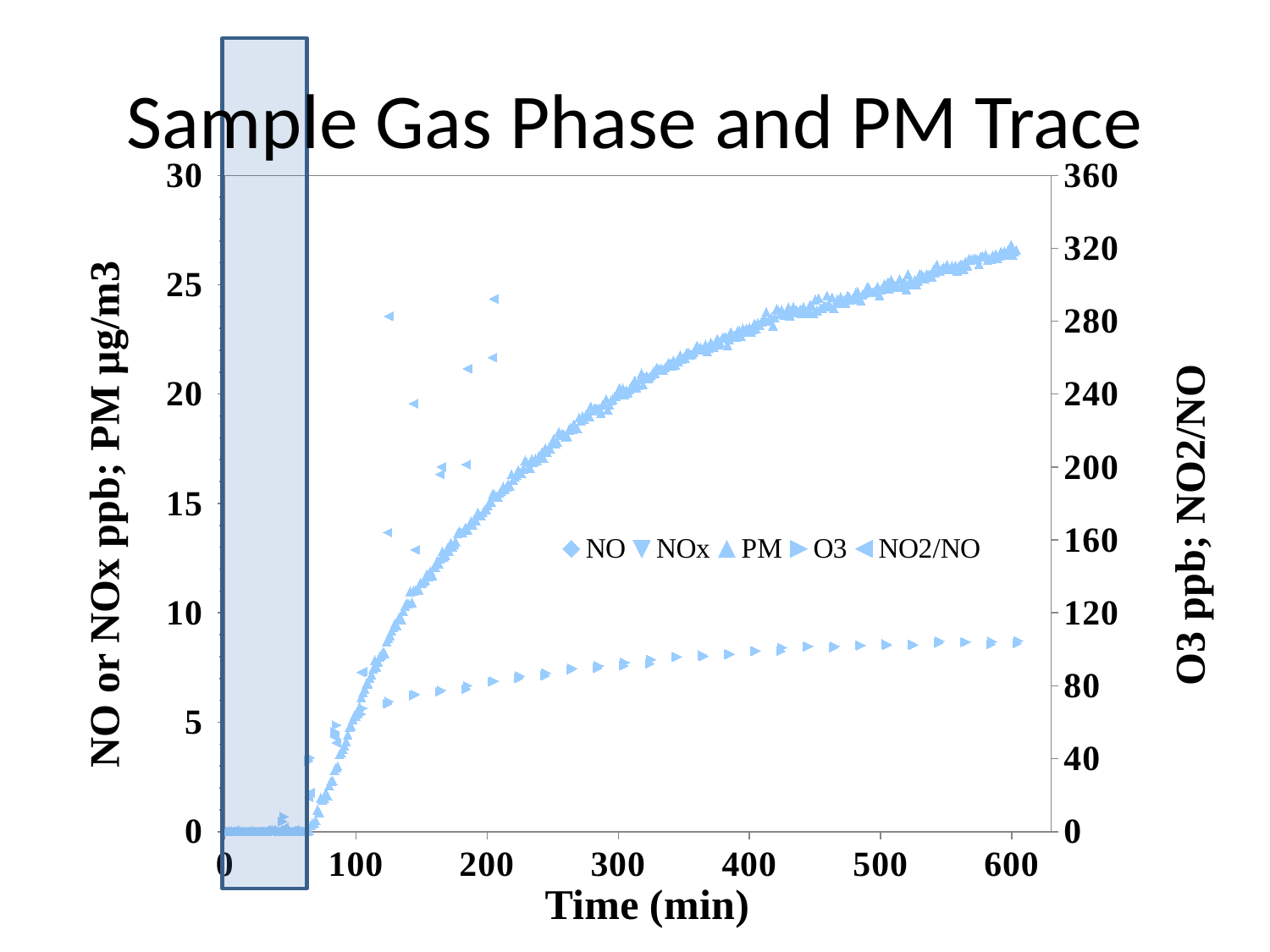
What is the label of the x axis? Time (min) What is the title of the chart? Sample Gas Phase and PM Trace Does the PM series rise or fall as time increases along the x axis? rise Is the O3 value at 200 min greater or less than 120 on the right axis? less Is the PM value at 600 min greater or less than 25 on the left axis? greater At 600 min, which series is higher on the chart, PM or O3? PM What kind of chart is shown on the slide? scatter chart Is the PM value at 300 min greater or less than 15 on the left axis? greater Does the O3 series rise or fall as time increases from 100 to 600 min? rise How many series does the legend list? 5